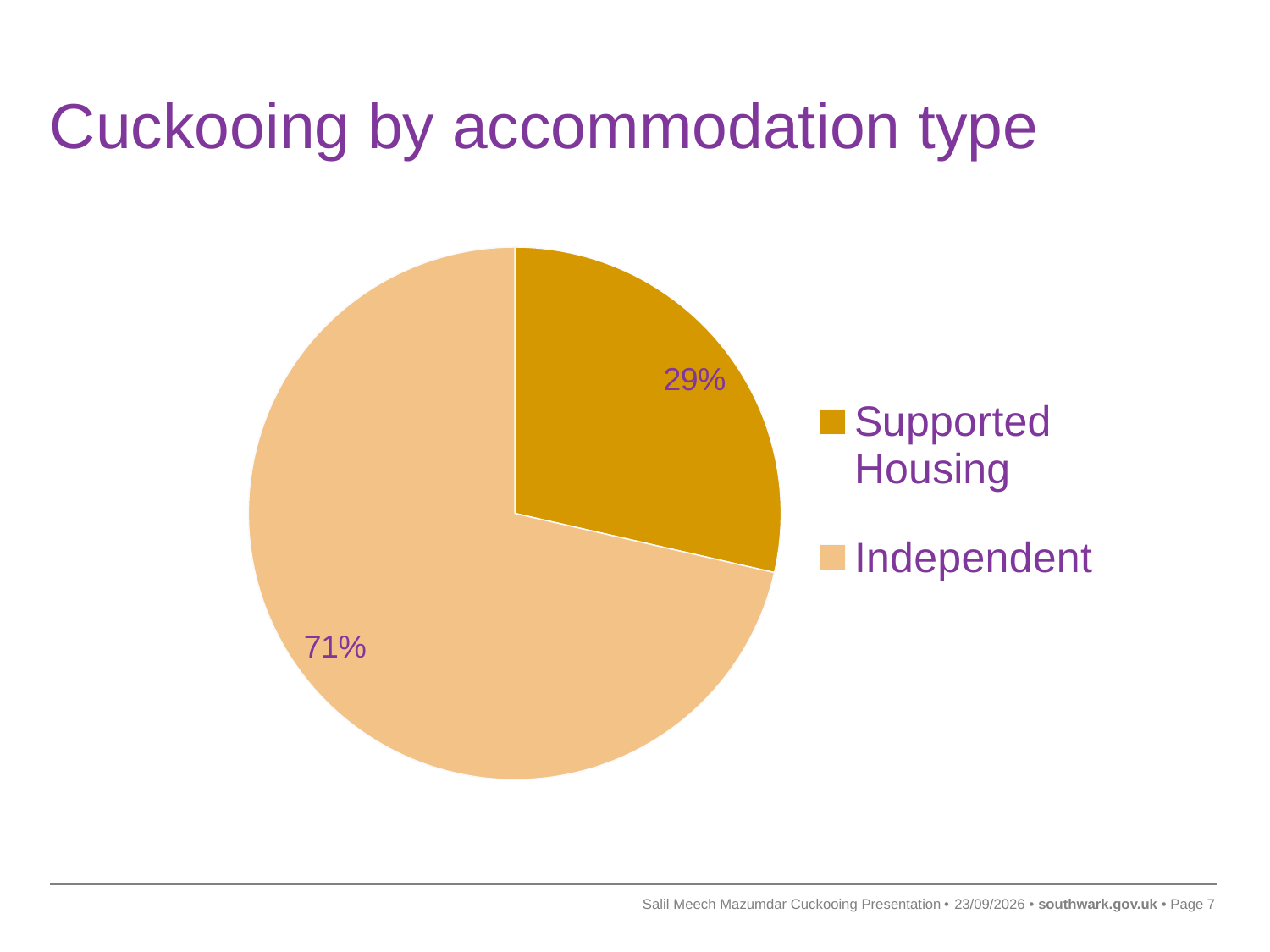
What share of the pie does Supported Housing represent? 29% What is the title of the slide containing the chart? Cuckooing by accommodation type Which accommodation type has the smallest share? Supported Housing Which accommodation type has the largest share? Independent What share of the pie does Independent represent? 71% Which is larger, the share for Supported Housing or the share for Independent? Independent What type of chart is shown on the slide? pie chart Which legend entry is shown in the darker orange colour? Supported Housing How many entries does the legend list? 2 What is the difference in percentage points between Independent and Supported Housing? 42 How many slices does the pie chart have? 2